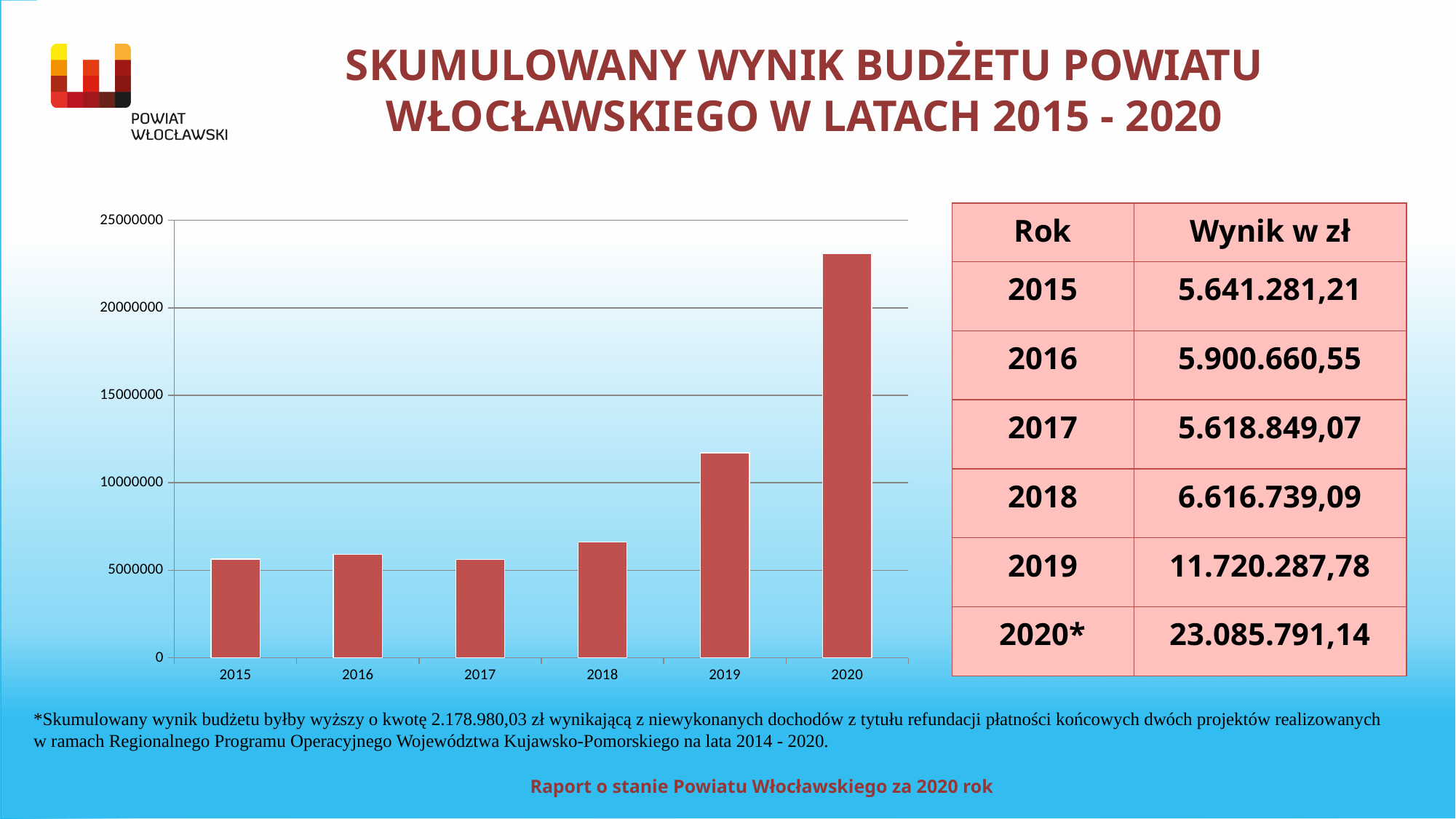
How many years are shown on the x axis of the chart? 6 What value is given for 2020 in the table? 23.085.791,14 Which is larger, the result for 2018 or for 2019? 2019 Is the bar for 2019 greater or less than 10000000? greater Do the values generally rise or fall from 2015 to 2020? rise What is the cumulative budget result for 2015? 5.641.281,21 Which year has the highest cumulative budget result? 2020 What kind of chart is shown on the slide? bar chart Is the bar for 2018 greater or less than 10000000? less What is the cumulative budget result for 2019 shown on the slide? 11.720.287,78 Which year has the lowest cumulative budget result according to the table? 2017 What is the difference between the 2020 and 2019 results? 11.365.503,36